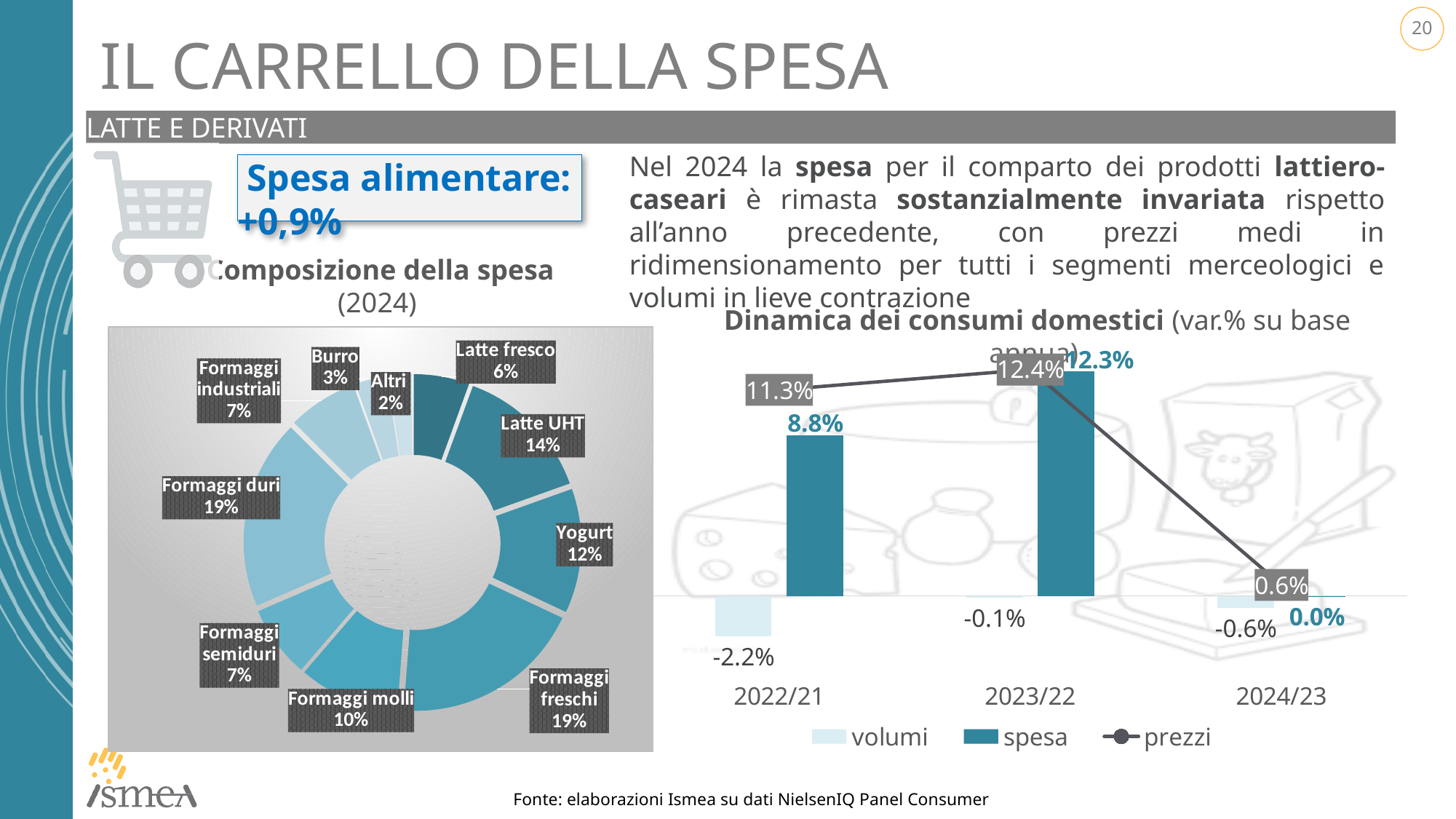
In the 'Dinamica dei consumi domestici' chart, what is the value of prezzi for 2023/22? 12.4% In the 'Composizione della spesa (2024)' chart, what share does Latte UHT have? 14% In the 'Dinamica dei consumi domestici' chart, what is the value of spesa for 2022/21? 8.8% In the 'Dinamica dei consumi domestici' chart, in which period is spesa highest? 2023/22 In the 'Composizione della spesa (2024)' chart, how many categories are shown? 10 In the 'Dinamica dei consumi domestici' chart, what is the difference in percentage points between prezzi and spesa in 2022/21? 2.5 In the 'Dinamica dei consumi domestici' chart, what is the value of volumi for 2024/23? -0.6% In the 'Composizione della spesa (2024)' chart, what share does Yogurt have? 12% In the 'Composizione della spesa (2024)' chart, which is larger: Formaggi molli or Formaggi semiduri? Formaggi molli In the 'Composizione della spesa (2024)' chart, which category has the smallest share? Altri In the 'Dinamica dei consumi domestici' chart, how many series does the legend list? 3 In the 'Composizione della spesa (2024)' chart, what is the difference in percentage points between Formaggi duri and Burro? 16